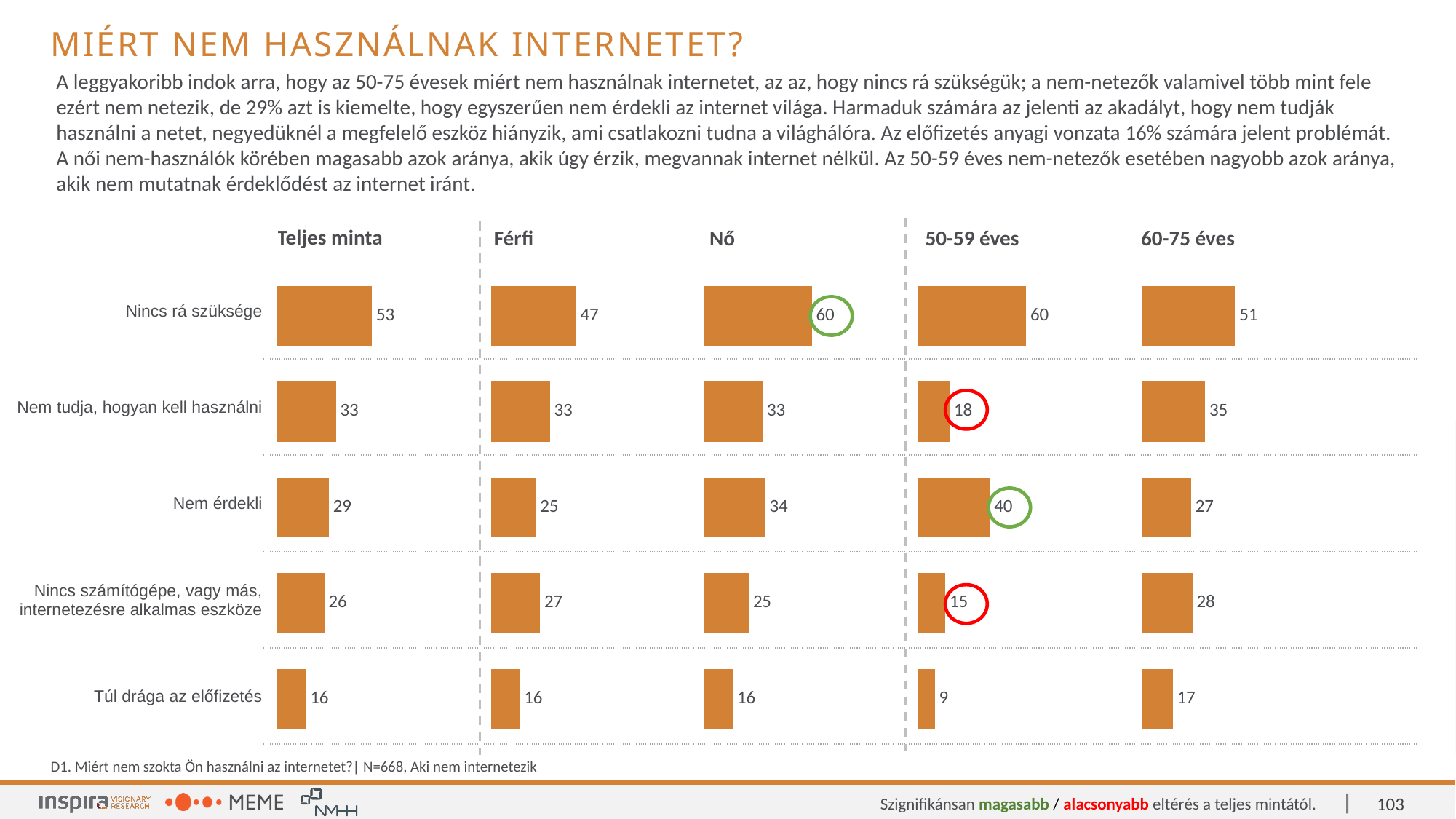
How many separate bar charts (sample groups) are shown on the slide? 5 What kind of chart is used for the Teljes minta data? Bar chart Which is larger: Nem tudja, hogyan kell használni in the 50-59 éves chart or in the 60-75 éves chart? 60-75 éves In the Férfi chart, which category has the lowest value? Túl drága az előfizetés In the Teljes minta chart, what is the value for Nincs rá szüksége? 53 In the 60-75 éves chart, which category has the highest value? Nincs rá szüksége In the 50-59 éves chart, what is the value for Túl drága az előfizetés? 9 In the 50-59 éves chart, what is the difference between Nincs rá szüksége and Nem érdekli? 20 In the Nő chart, what is the difference between Nincs rá szüksége and Túl drága az előfizetés? 44 How many categories are shown in the Teljes minta chart? 5 In the 60-75 éves chart, what is the value for Nincs számítógépe, vagy más, internetezésre alkalmas eszköze? 28 In the Nő chart, what is the value for Nem érdekli? 34